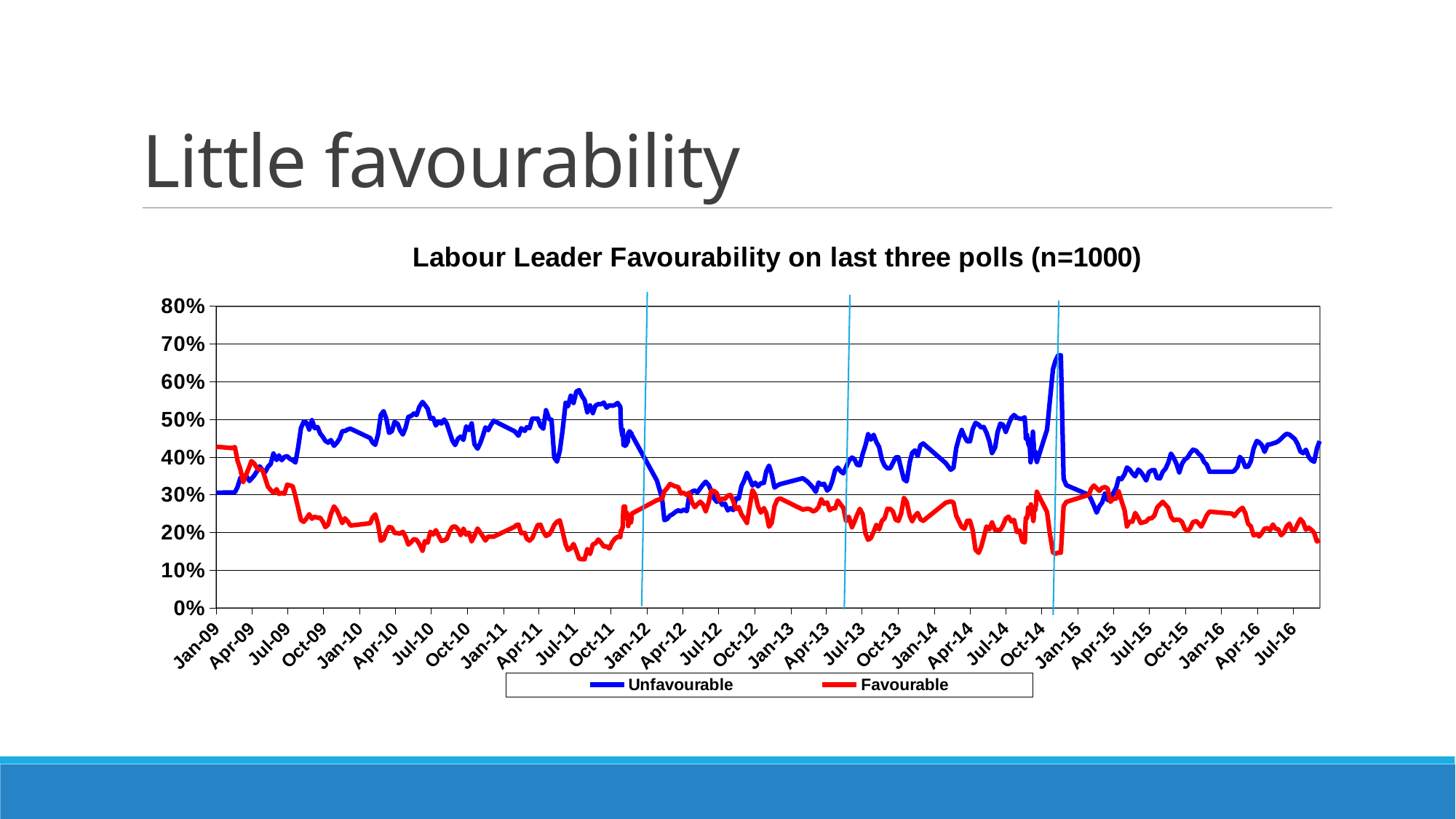
Is the Favourable value at Jan-09 greater or less than 40%? greater At Jul-11, which series has the higher value, Unfavourable or Favourable? Unfavourable Does the Unfavourable series rise or fall between Jan-09 and Oct-09? rise Does the Favourable series rise or fall between Jan-09 and Jul-09? fall Is the peak value of the Unfavourable series around Nov-14 greater or less than 60%? greater Which colour is used for the Favourable series? red What kind of chart is shown on the slide? line chart How many series does the legend list? 2 Is the Favourable value around Jul-11 greater or less than 20%? less What is the title of the chart? Labour Leader Favourability on last three polls (n=1000) At Jan-09, which series has the higher value, Unfavourable or Favourable? Favourable